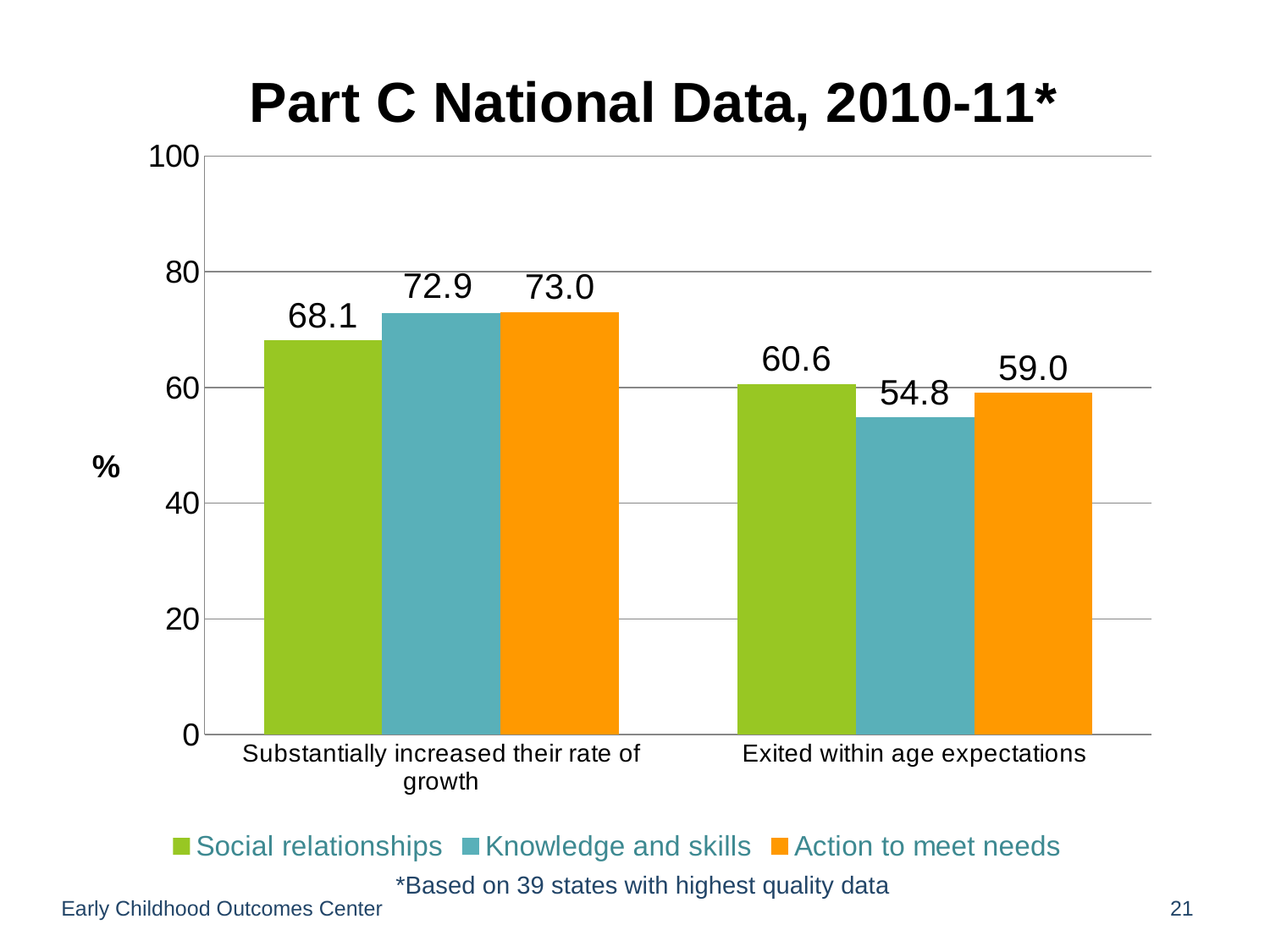
What is the difference between Action to meet needs and Knowledge and skills in the 'Exited within age expectations' category? 4.2 What is the value for Social relationships in the 'Substantially increased their rate of growth' category? 68.1 What is the value for Action to meet needs in the 'Substantially increased their rate of growth' category? 73.0 Which is larger: Social relationships or Knowledge and skills in the 'Substantially increased their rate of growth' category? Knowledge and skills Which series has the lowest value in the 'Exited within age expectations' category? Knowledge and skills Which series has the highest value in the 'Exited within age expectations' category? Social relationships How many categories are shown on the x axis? 2 What type of chart is shown on the slide? Bar chart Is the value for Knowledge and skills in 'Exited within age expectations' greater or less than 60? less What is the difference between the Social relationships values for 'Substantially increased their rate of growth' and 'Exited within age expectations'? 7.5 What is the value for Knowledge and skills in the 'Exited within age expectations' category? 54.8 How many series does the legend list? 3